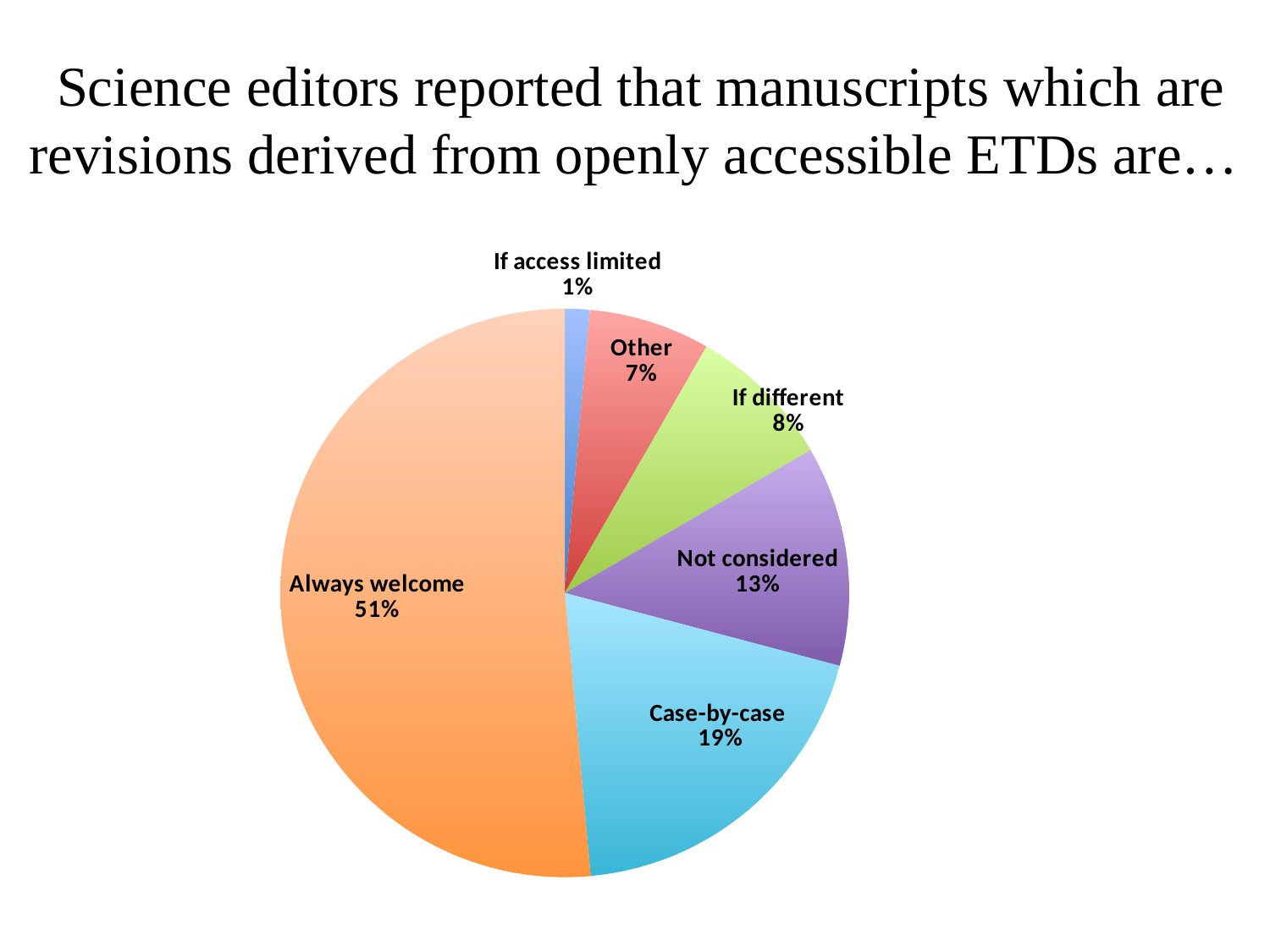
What is the value for 'Other'? 7% What share of the pie is labelled 'Case-by-case'? 19% Which category has the smallest slice of the pie? If access limited How many slices does the pie chart have? 6 Which is larger, 'Not considered' or 'If different'? Not considered What is the value for 'If different'? 8% What percentage of science editors reported that such manuscripts are always welcome? 51% What colour is the 'Always welcome' slice? orange What is the difference in percentage points between 'Always welcome' and 'Case-by-case'? 32 What kind of chart is shown on the slide? pie chart What is the value for 'Not considered'? 13% Which category has the largest slice of the pie? Always welcome